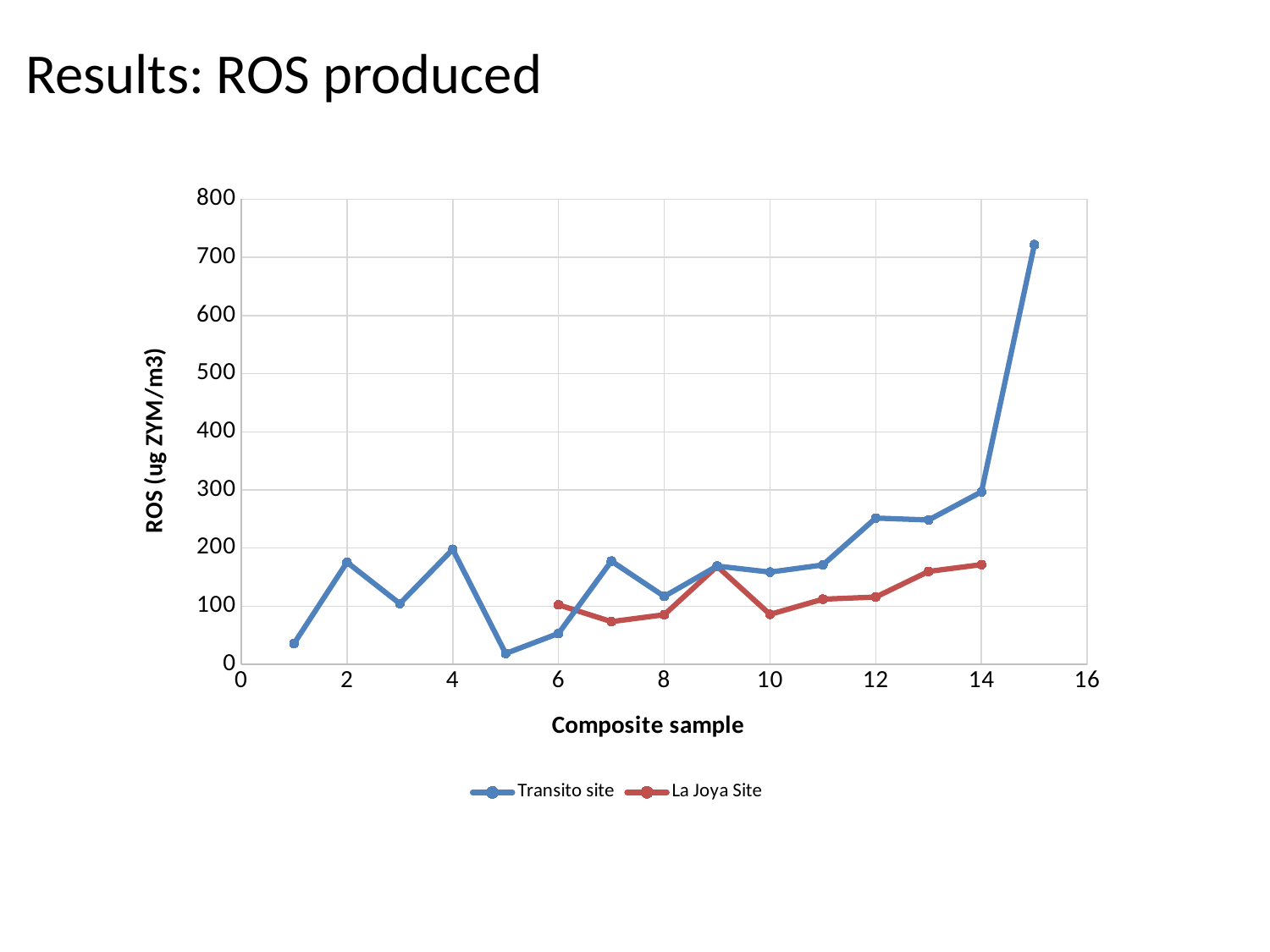
Is the Transito site value at composite sample 15 greater or less than 700? greater At which composite sample does the Transito site series reach its lowest value? 5 How many data points are plotted for the La Joya Site series? 9 What is the y-axis title of the chart? ROS (ug ZYM/m3) What kind of chart is shown on the slide? line chart How many series does the legend list? 2 How many data points are plotted for the Transito site series? 15 At which composite sample does the Transito site series reach its highest value? 15 Is the La Joya Site value at composite sample 7 greater or less than 100? less Which series are listed in the legend? Transito site and La Joya Site At composite sample 12, which series has the larger value, Transito site or La Joya Site? Transito site Does the Transito site series rise or fall between composite samples 12 and 15? rise